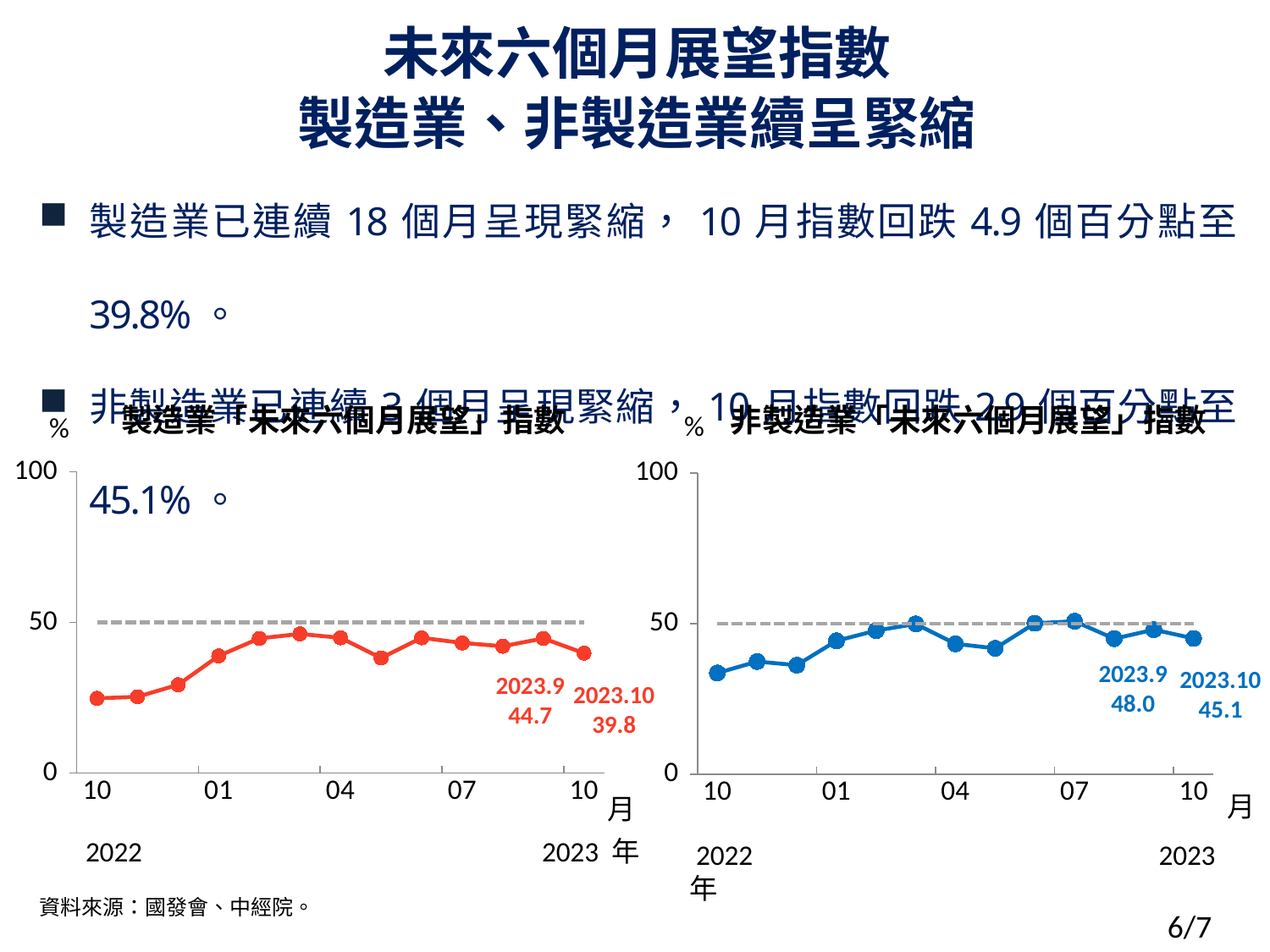
In the 非製造業「未來六個月展望」指數 chart (right), what is the value labelled for 2023.10? 45.1 In the 製造業「未來六個月展望」指數 chart (left), what is the value labelled for 2023.9? 44.7 Comparing the 2023.10 labelled values, which chart shows the higher value: 製造業 (left) or 非製造業 (right)? 非製造業 (right) In the 非製造業「未來六個月展望」指數 chart (right), what is the value labelled for 2023.9? 48.0 In the 非製造業「未來六個月展望」指數 chart (right), by how much did the index fall from 2023.9 to 2023.10? 2.9 At what value is the horizontal dashed reference line drawn in both charts? 50 In the 非製造業「未來六個月展望」指數 chart (right), is the value for 2022.10 greater or less than 50? less In the 製造業「未來六個月展望」指數 chart (left), is the value for 2022.10 greater or less than 50? less What type of chart is the 製造業「未來六個月展望」指數 chart (left)? line chart In the 製造業「未來六個月展望」指數 chart (left), what is the value labelled for 2023.10? 39.8 In the 製造業「未來六個月展望」指數 chart (left), by how much did the index fall from 2023.9 to 2023.10? 4.9 In the 非製造業「未來六個月展望」指數 chart (right), does the index rise or fall from 2023.9 to 2023.10? fall